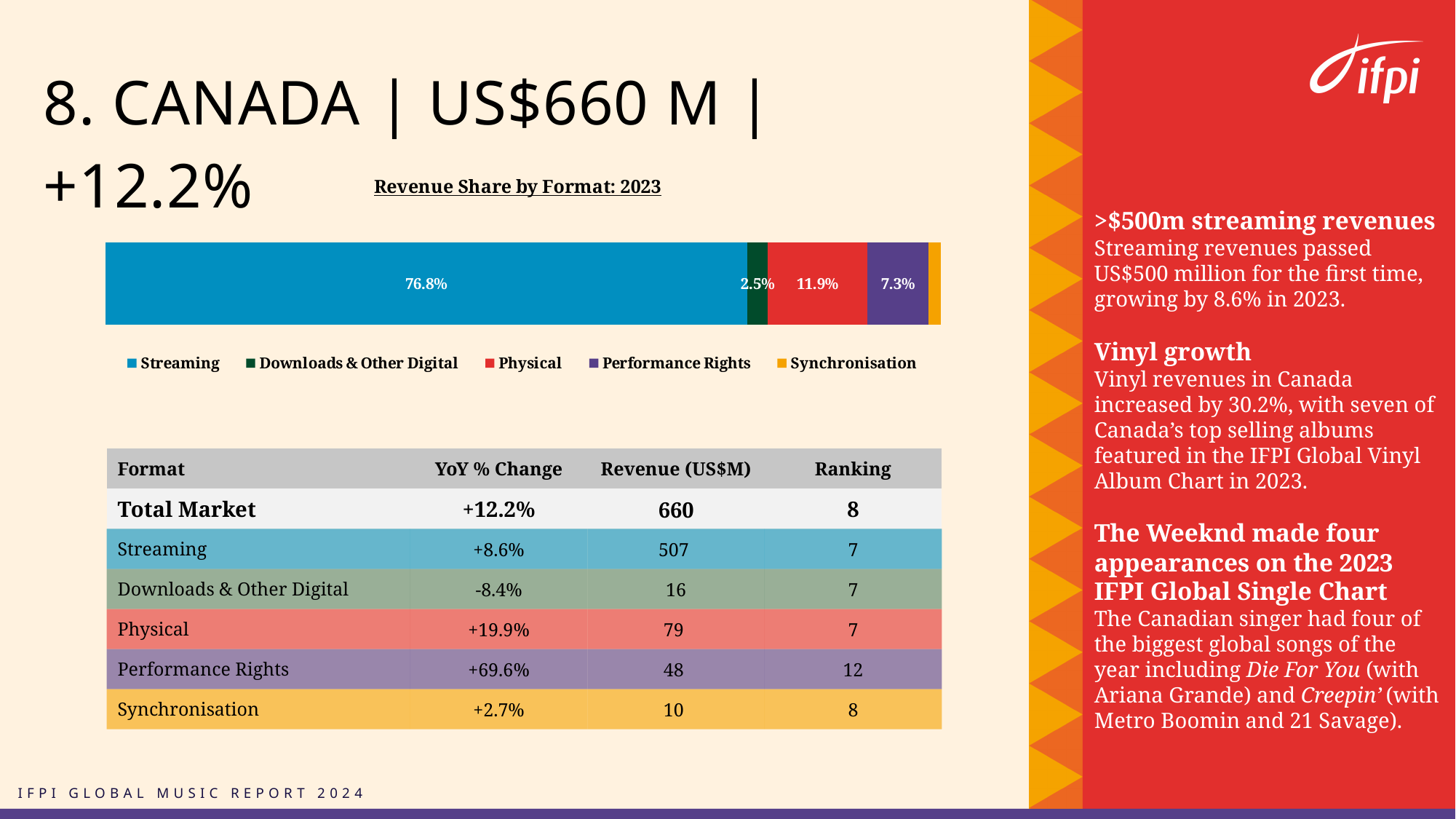
In the chart, how much larger is the Physical share than the Performance Rights share? 4.6% In the chart, what colour represents Streaming? Blue What is the title of the chart? Revenue Share by Format: 2023 What share of revenue does Streaming have in the chart? 76.8% Which format has the smallest share in the chart? Synchronisation How many series does the chart legend list? 5 What share of revenue does Downloads & Other Digital have in the chart? 2.5% What share of revenue does Physical have in the chart? 11.9% Which format has the largest share in the chart? Streaming In the chart, which has the larger share: Physical or Performance Rights? Physical What kind of chart is shown under the title "Revenue Share by Format: 2023"? Stacked bar chart What share of revenue does Performance Rights have in the chart? 7.3%